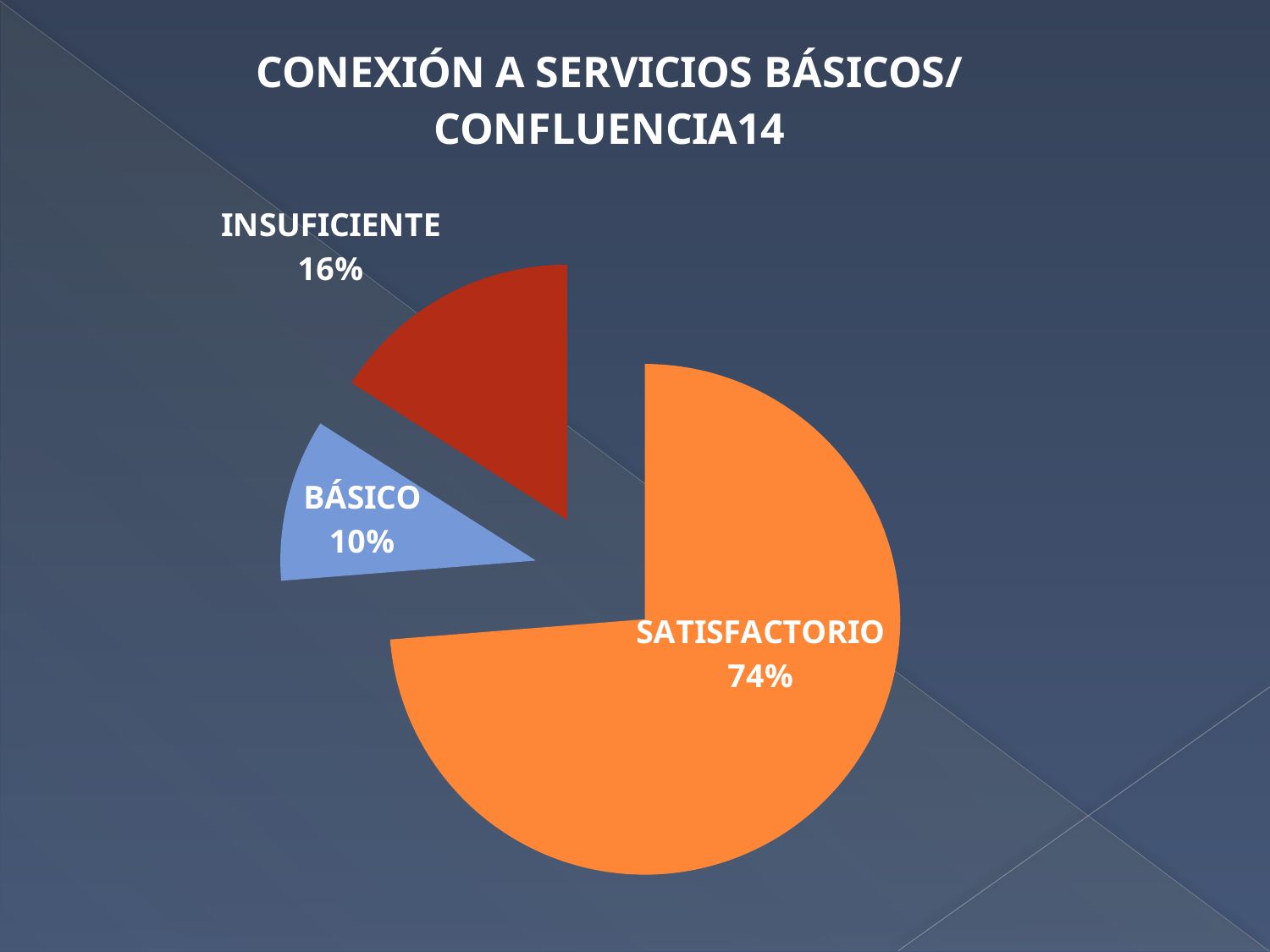
What percentage is shown for SATISFACTORIO? 74% What percentage is shown for INSUFICIENTE? 16% What colour is the SATISFACTORIO slice? orange What is the difference in percentage points between SATISFACTORIO and INSUFICIENTE? 58 Which is larger, the INSUFICIENTE slice or the BÁSICO slice? INSUFICIENTE What percentage is shown for BÁSICO? 10% What is the difference in percentage points between INSUFICIENTE and BÁSICO? 6 Which category has the smallest slice of the pie? BÁSICO How many slices does the pie chart have? 3 Which category has the largest slice of the pie? SATISFACTORIO What is the title of the chart? CONEXIÓN A SERVICIOS BÁSICOS/ CONFLUENCIA14 What kind of chart is shown on the slide? pie chart